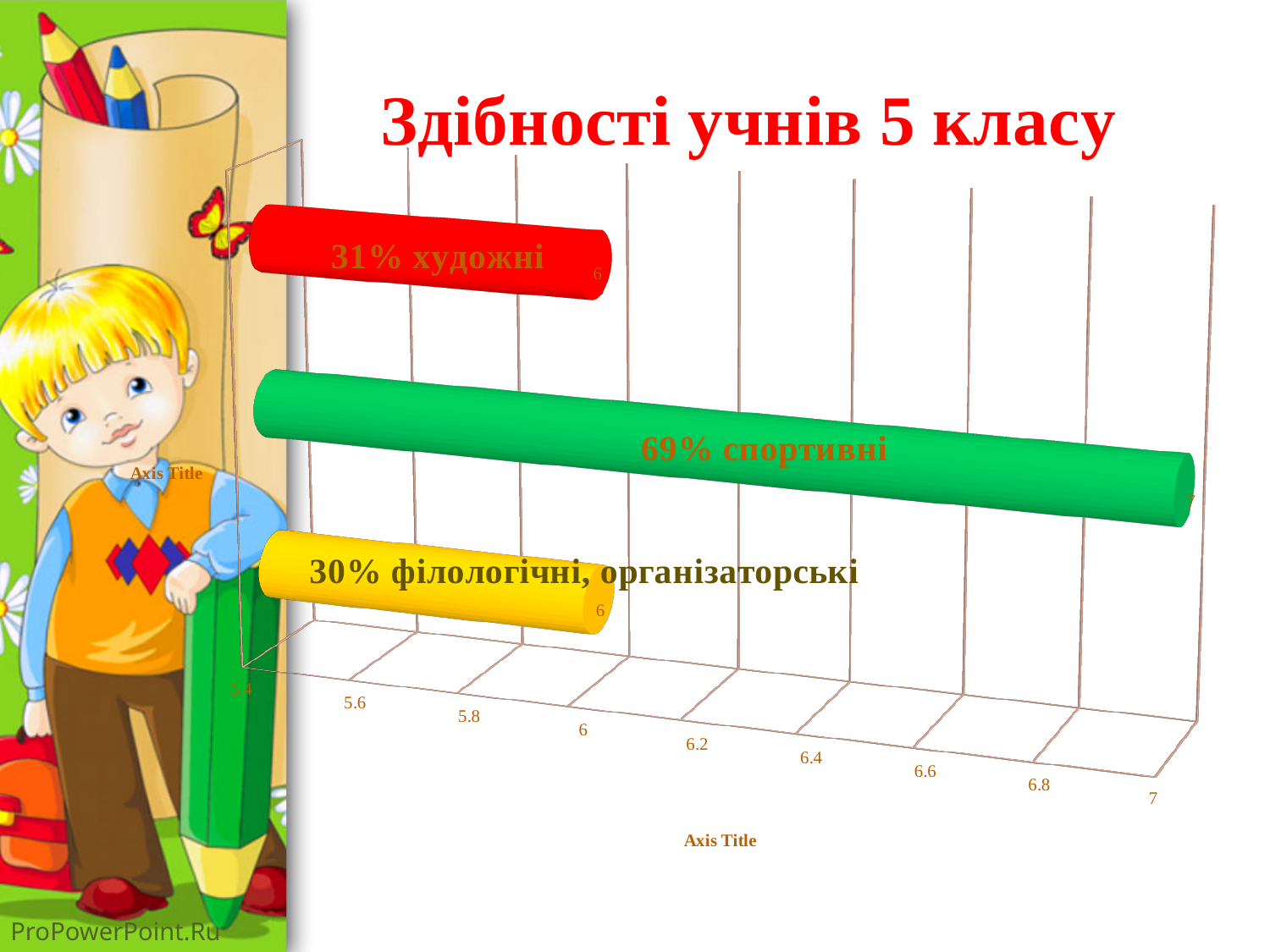
What is the value for 31% художні? 6 What is the title of the chart? Здібності учнів 5 класу What is the value for 69% спортивні? 7 How many bars does the chart show? 3 What is the difference between the value for 69% спортивні and the value for 31% художні? 1 Is the value for 69% спортивні greater or less than 6.8? greater Which is larger: the value for 69% спортивні or the value for 31% художні? 69% спортивні What is the value for 30% філологічні, організаторські? 6 What kind of chart is shown on the slide? bar chart Is the value for 31% художні greater or less than 6.2? less Which category has the highest value? 69% спортивні What colour is the bar for 69% спортивні? green